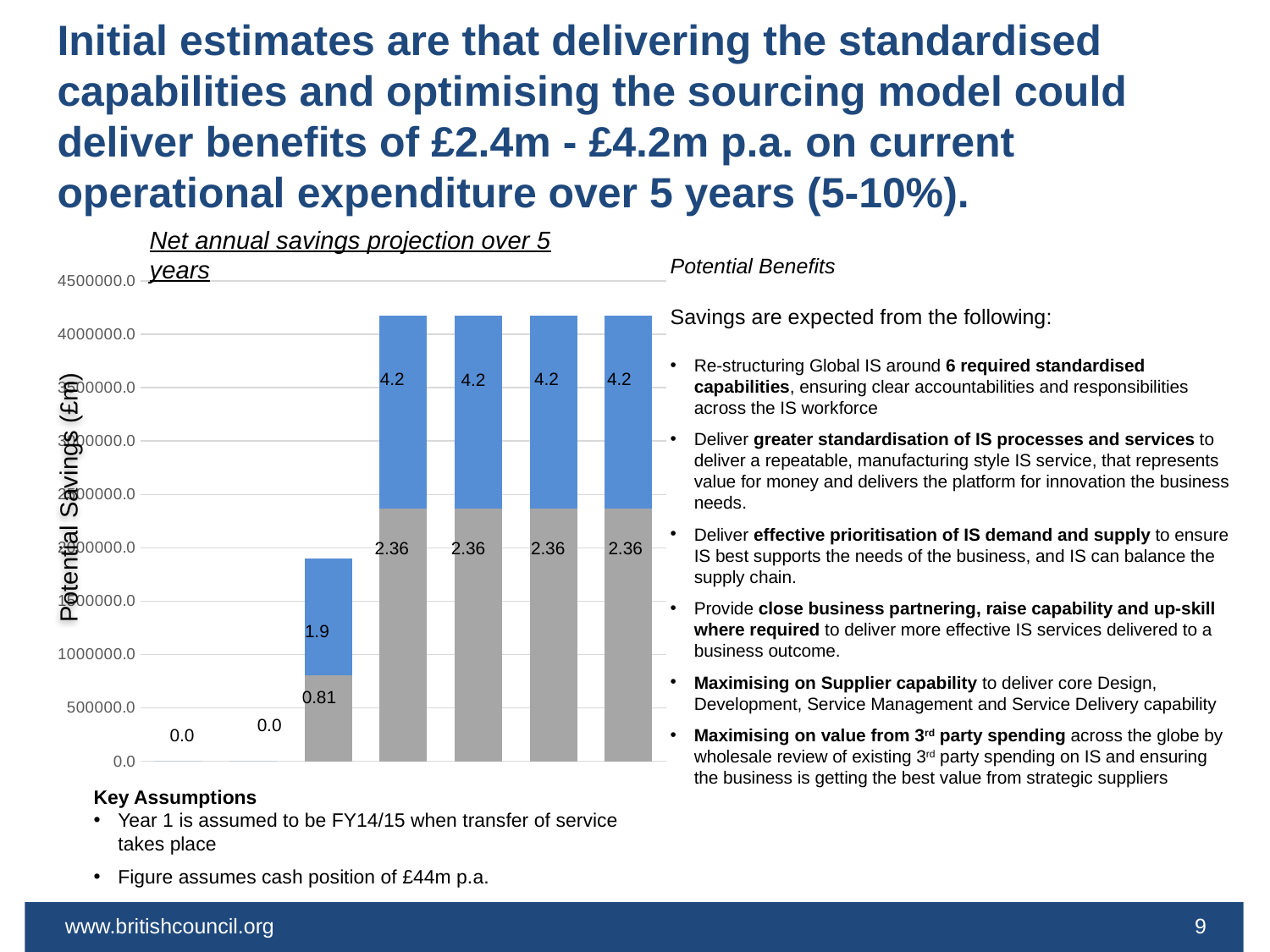
What is the title of the chart? Net annual savings projection over 5 years What value is printed on the grey portion of the tallest bars in the chart? 2.36 What is the difference between the grey value on the tallest bars (2.36) and the grey value on the shorter bar (0.81)? 1.55 What value is printed on the grey portion of the shorter bar that sits just left of the tallest bars? 0.81 Is the top of the tallest bars greater or less than the 4000000.0 axis tick? greater What is the label on the vertical axis of the chart? Potential Savings (£m) Do the bar heights rise or fall from left to right across the chart? Rise What kind of chart is shown on the slide? Bar chart What value is printed on the blue portion of the shorter bar that sits just left of the tallest bars? 1.9 What is the difference between the blue value on the tallest bars (4.2) and the blue value on the shorter bar (1.9)? 2.3 Which is larger: the blue value 1.9 on the shorter bar or the blue value 4.2 on the tallest bars? 4.2 What value is printed on the blue portion of the tallest bars in the chart? 4.2